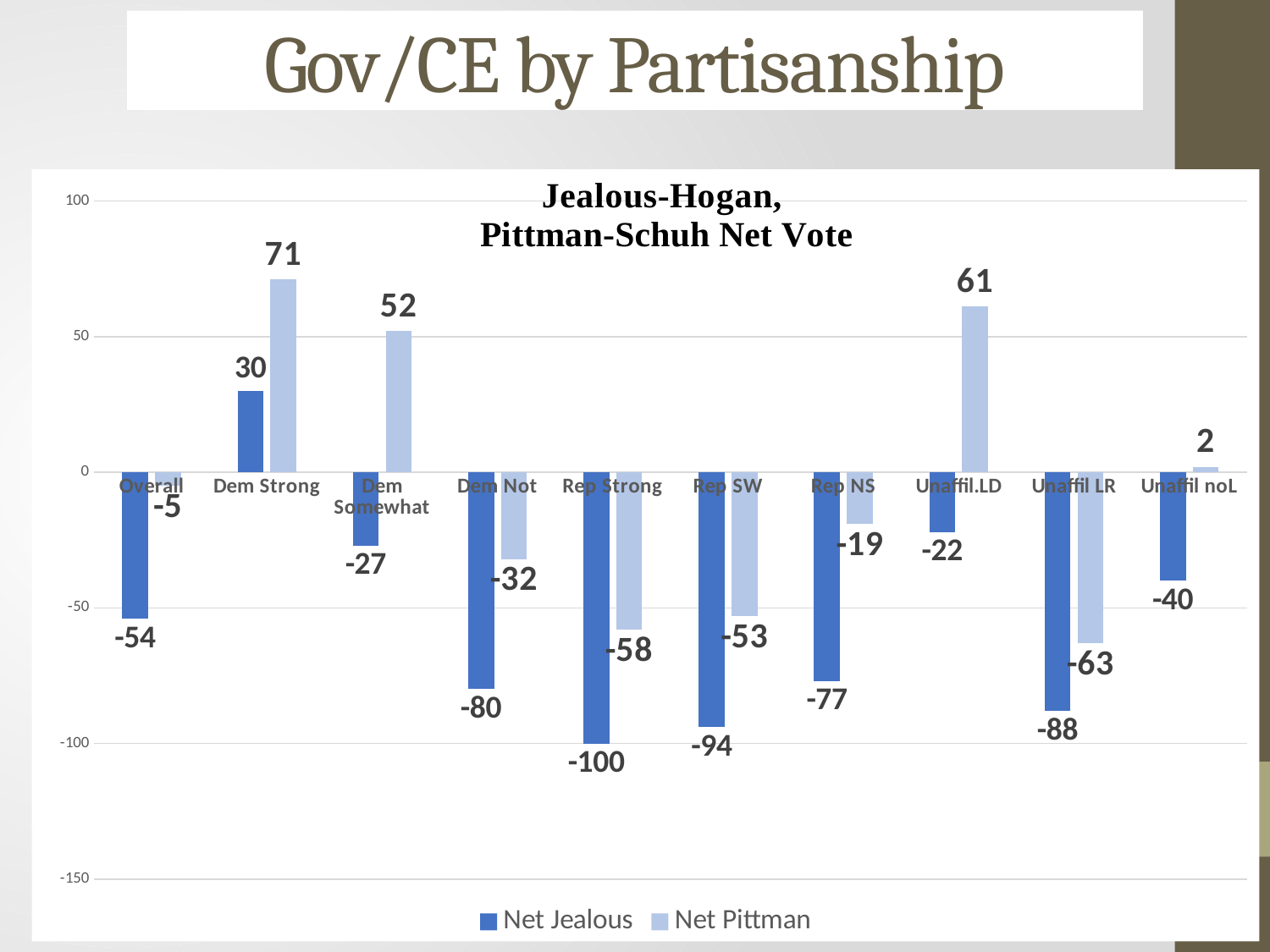
Which category has the highest Net Pittman value? Dem Strong How many series does the legend list? 2 What is the Net Pittman value for Unaffil.LD? 61 Which is larger, the Net Jealous value for Rep SW or for Rep NS? Rep NS What is the Net Jealous value for Rep Strong? -100 How many partisanship categories are shown on the x axis? 10 Which category has the lowest Net Jealous value? Rep Strong What is the Net Pittman value for Dem Strong? 71 What kind of chart is shown on the slide? Bar chart What is the Net Jealous value for Overall? -54 For Unaffil LR, what is the difference between the Net Pittman value and the Net Jealous value? 25 For Dem Strong, what is the difference between the Net Pittman value and the Net Jealous value? 41